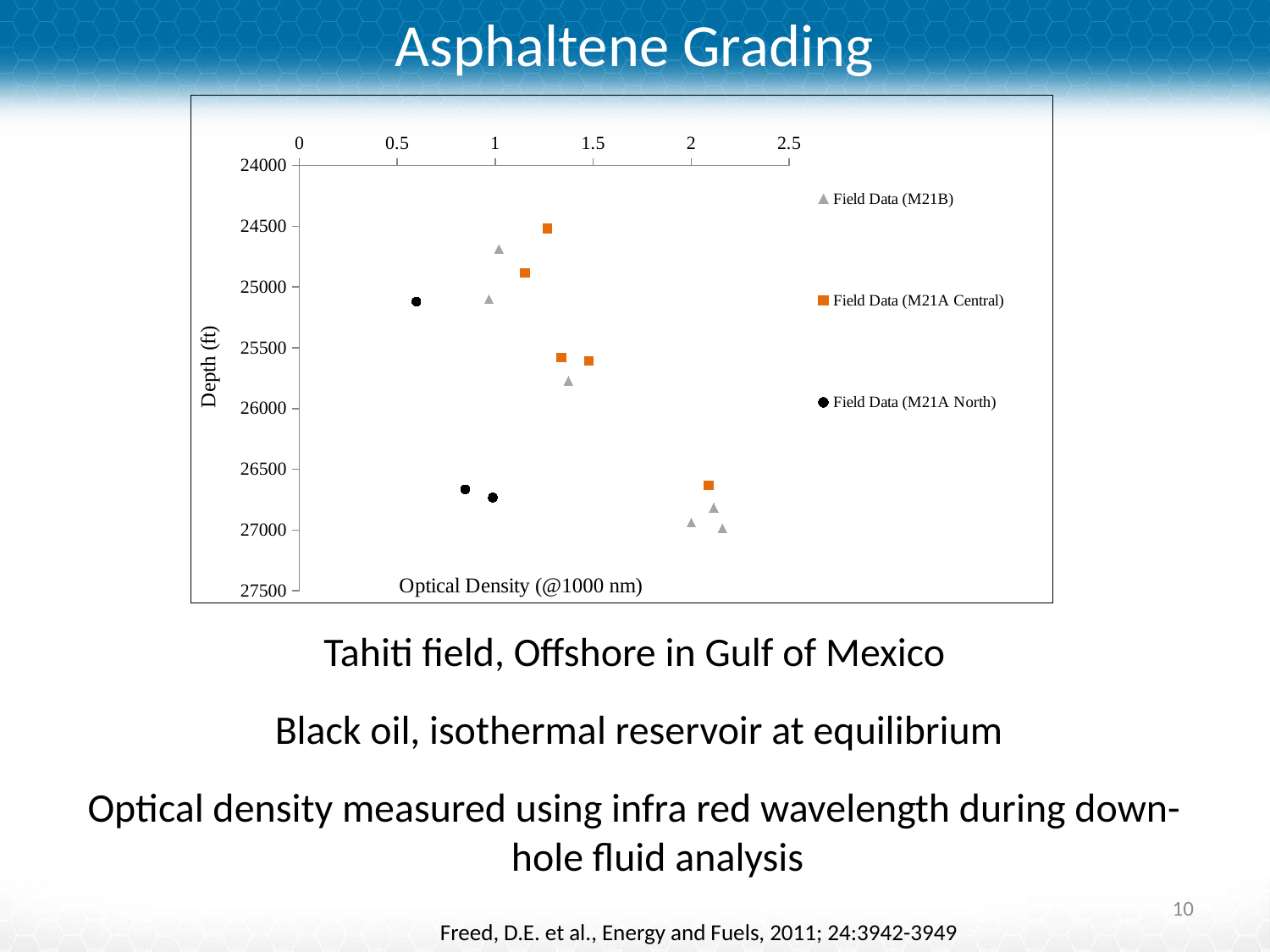
How many data points are plotted for the Field Data (M21A Central) series? 5 Which series is plotted with orange square markers? Field Data (M21A Central) Is the optical density of the deepest Field Data (M21A Central) point greater or less than 2? greater What is the label of the vertical axis? Depth (ft) Which series has the point with the lowest optical density on the chart? Field Data (M21A North) How many data points are plotted for the Field Data (M21A North) series? 3 Do the optical density values of the Field Data (M21B) series generally increase or decrease as depth increases? increase What is the label of the horizontal axis? Optical Density (@1000 nm) How many series does the legend list? 3 Is the optical density of the shallowest Field Data (M21A North) point greater or less than 1? less Is the optical density of the shallowest Field Data (M21A Central) point greater or less than 1? greater What kind of chart is shown on the slide? scatter chart